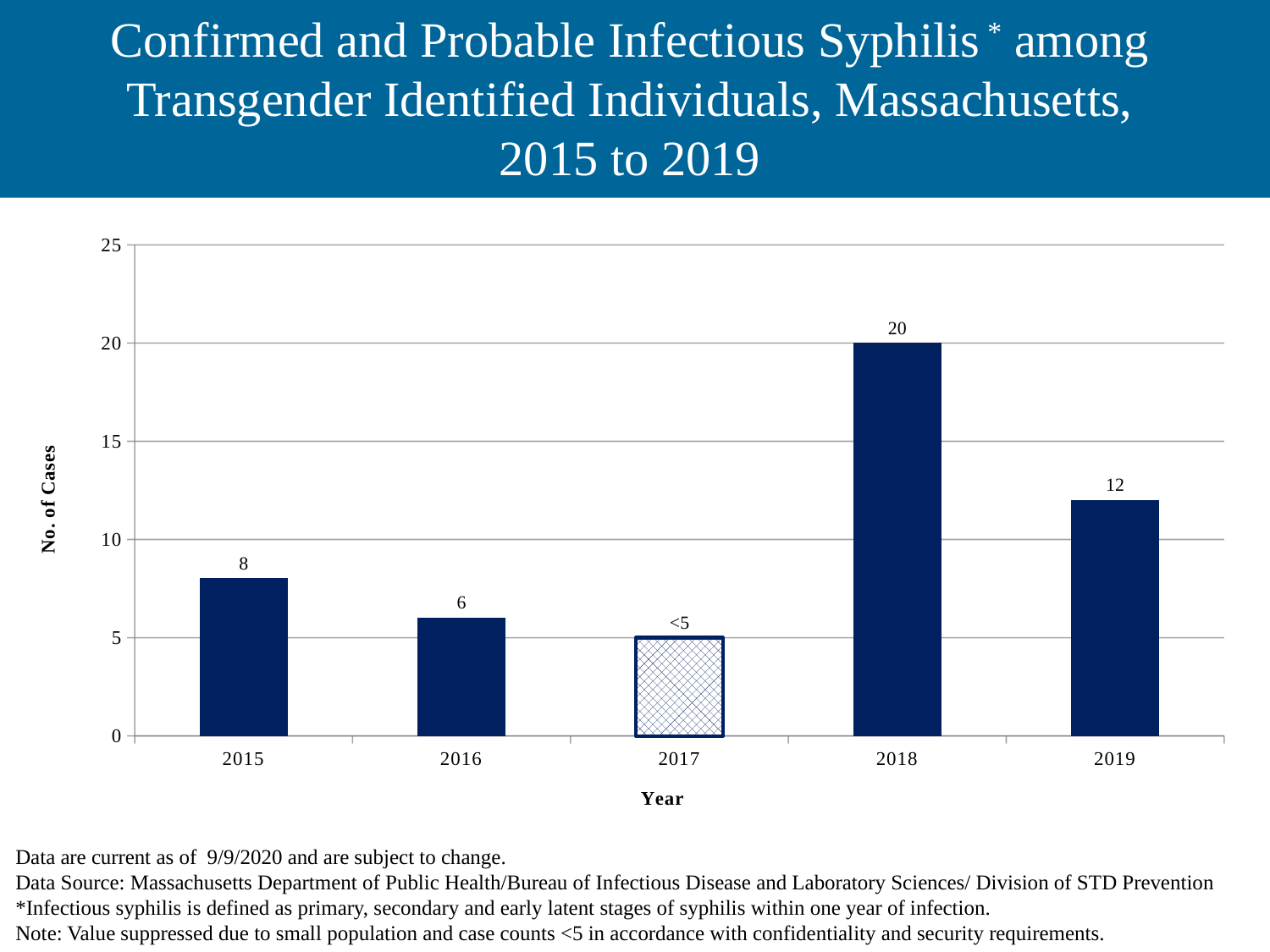
What kind of chart is this? Bar chart What label is shown on the bar for 2017? <5 Is the value for 2019 greater or less than 10? greater Which year has the lowest number of cases? 2017 Which year has the highest number of cases? 2018 What is the number of cases for 2019? 12 What is the label of the y axis? No. of Cases How many cases are shown for 2018? 20 Which year has more cases, 2015 or 2016? 2015 What is the number of cases for 2015? 8 How many years are shown on the x axis? 5 What is the difference in cases between 2018 and 2019? 8